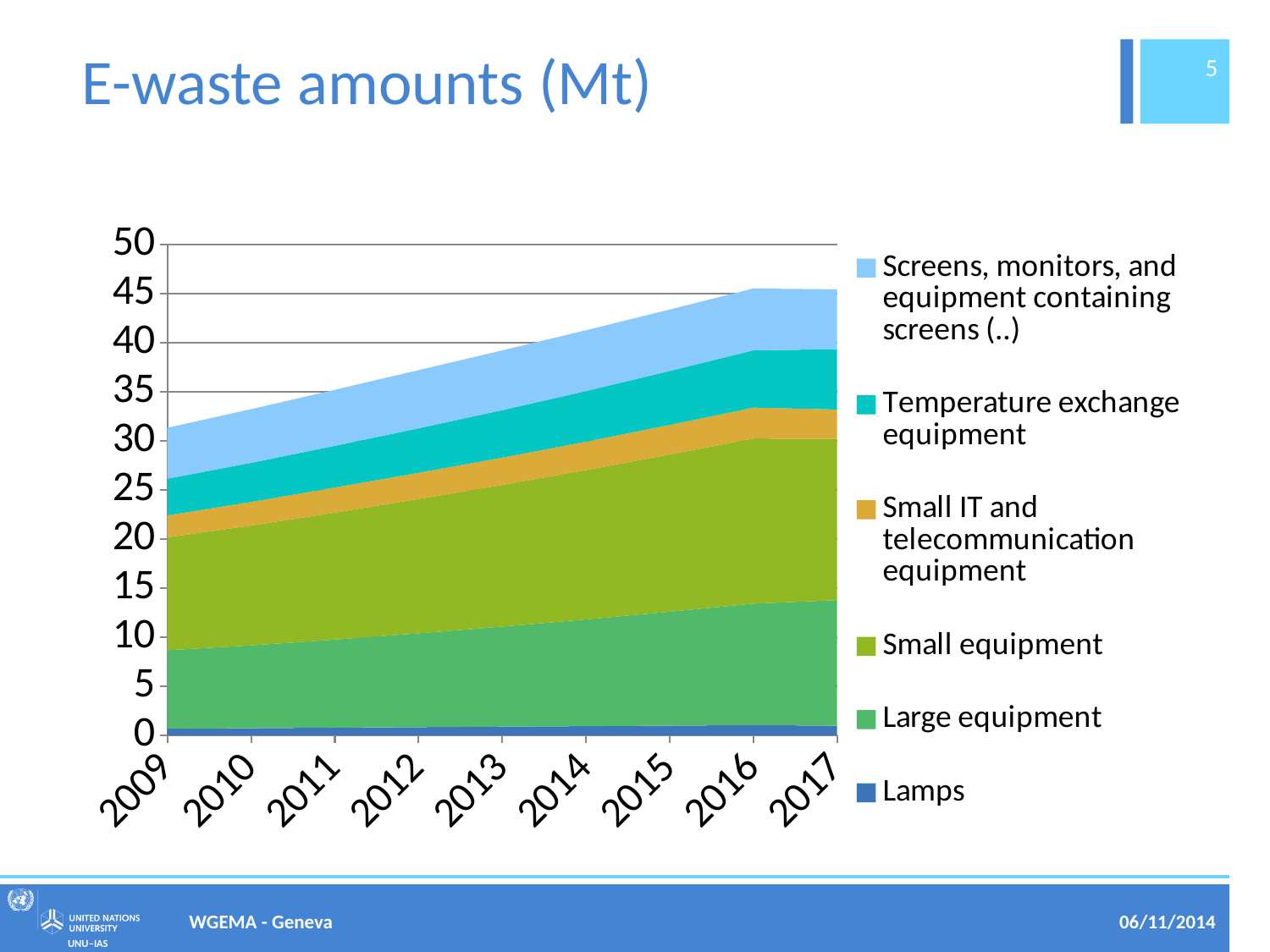
Is the total e-waste amount for 2010 greater or less than 35? less Which year has a larger total e-waste amount, 2009 or 2017? 2017 How many years are shown along the x axis? 9 How many series does the legend list? 6 Which series occupies the largest band of the stacked area in every year? Small equipment What is the title of the chart? E-waste amounts (Mt) Is the total e-waste amount for 2012 greater or less than 40? less Which series is listed last (at the bottom) in the legend? Lamps What kind of chart is shown on the slide? Stacked area chart Does the total e-waste amount rise or fall from 2009 to 2016? rise Is the total e-waste amount for 2017 greater or less than 40? greater